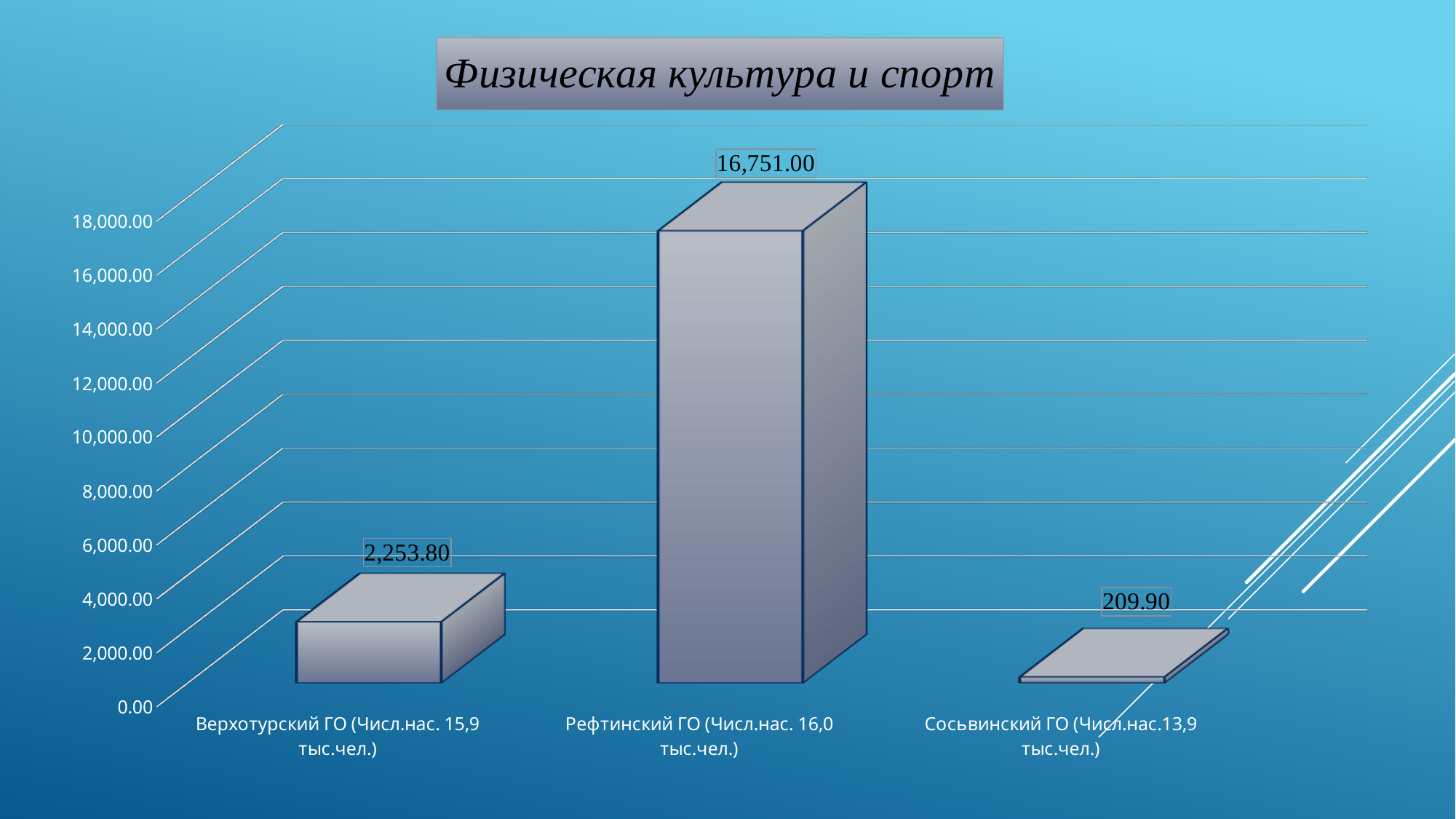
What is the difference between the values for Верхотурский ГО and Сосьвинский ГО? 2,043.90 What is the value for Сосьвинский ГО? 209.90 Which category has the highest value? Рефтинский ГО How many categories are shown in the chart? 3 Which is larger, the value for Верхотурский ГО or the value for Сосьвинский ГО? Верхотурский ГО Is the value for Рефтинский ГО greater or less than 16,000.00? greater What is the value for Верхотурский ГО? 2,253.80 What kind of chart is shown on the slide? bar chart What is the difference between the values for Рефтинский ГО and Верхотурский ГО? 14,497.20 What is the value for Рефтинский ГО? 16,751.00 What is the title of the chart? Физическая культура и спорт Which category has the lowest value? Сосьвинский ГО